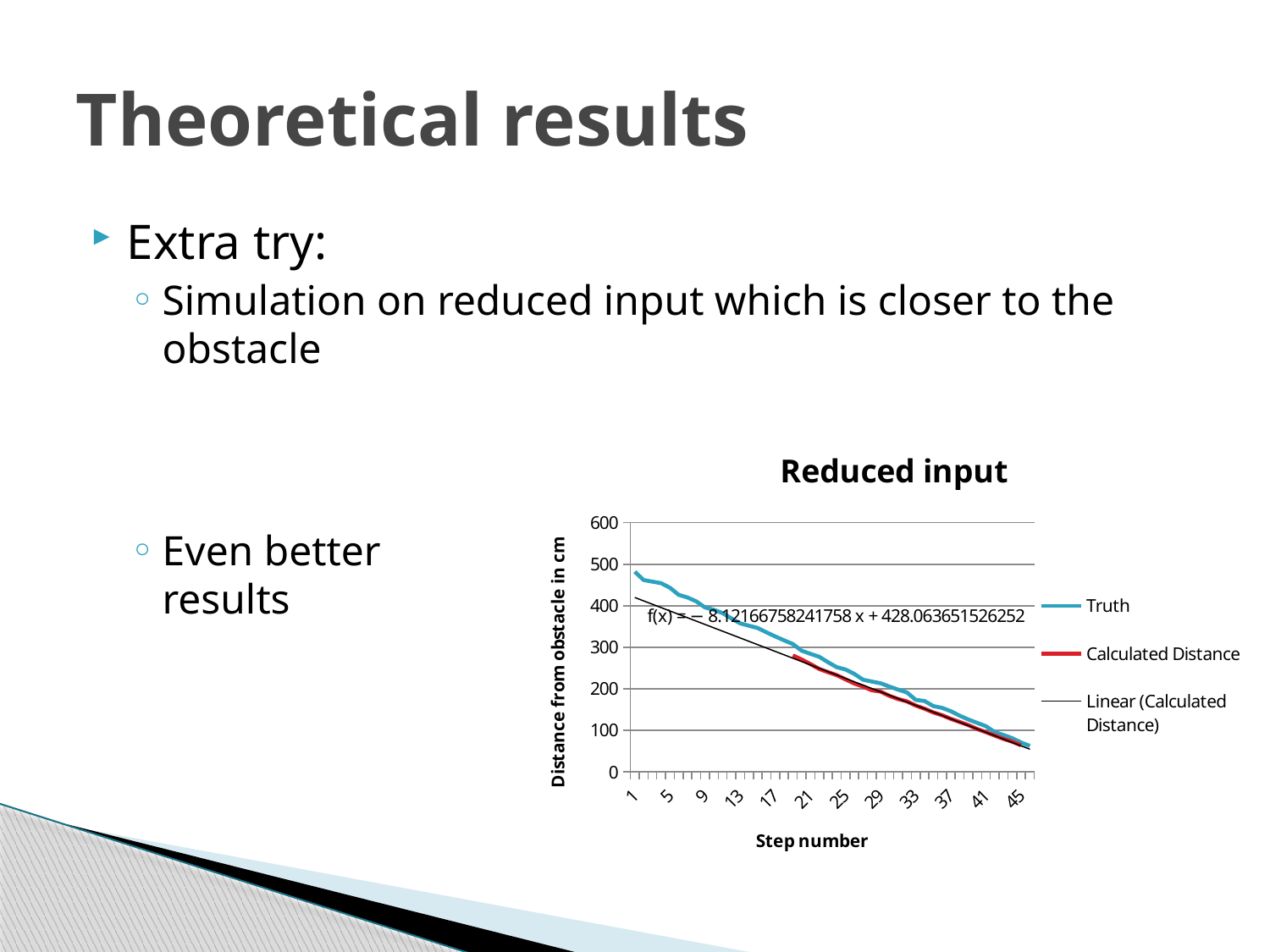
Is the Truth value at step 45 greater or less than 100? less What is the highest value shown on the chart's y axis? 600 Is the Calculated Distance value at step 45 greater or less than 100? less What is the slope shown in the trendline equation on the chart? −8.12166758241758 What is the title of the chart? Reduced input How many series does the chart's legend list? 3 Do the Truth values rise or fall as the step number increases? fall What is the intercept shown in the trendline equation on the chart? 428.063651526252 Is the Truth value at step 1 greater or less than 400? greater Which series is drawn in red in the chart? Calculated Distance What kind of chart is shown on the slide? line chart